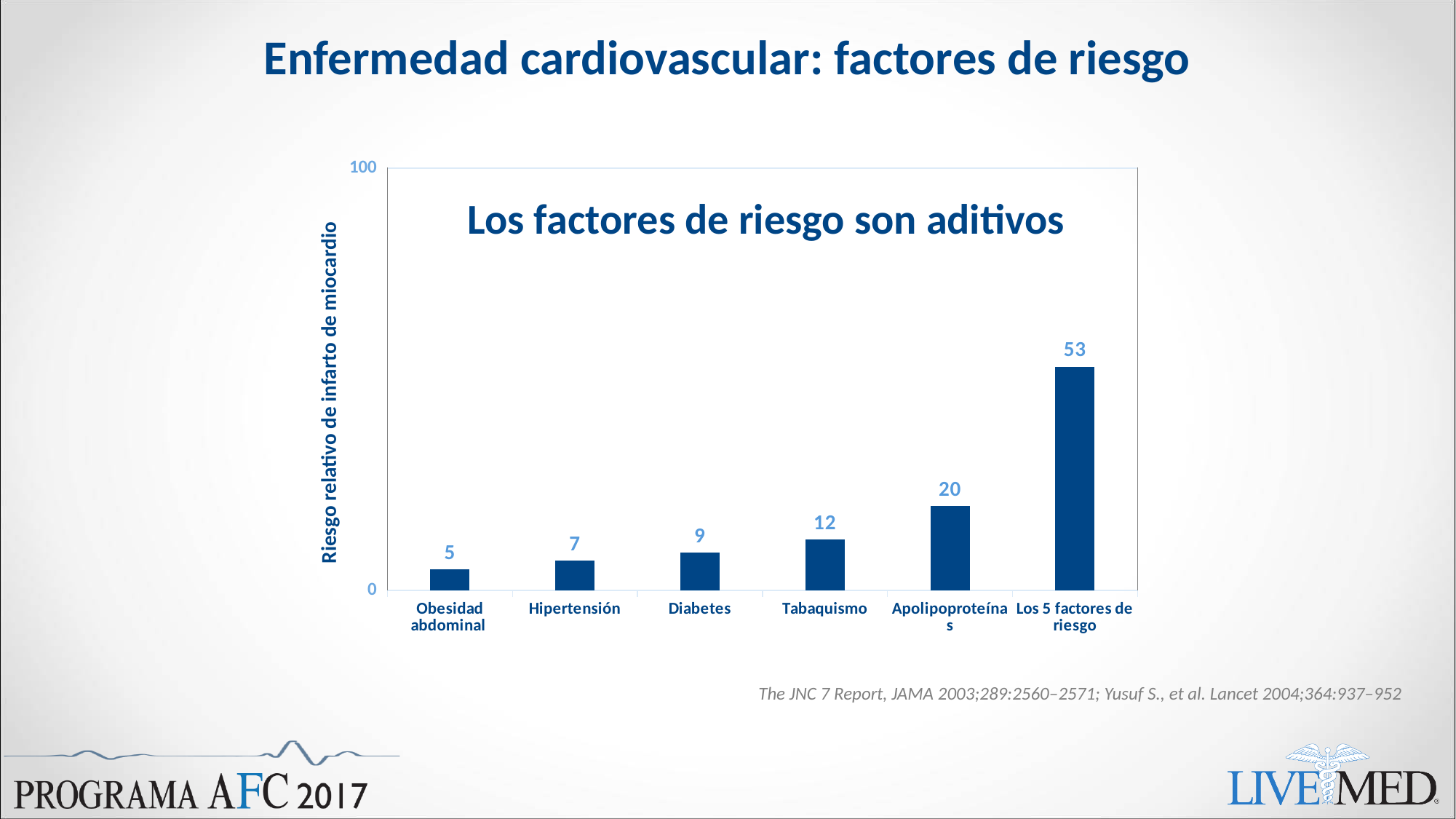
What is the value for Tabaquismo? 12 Do the values rise or fall from left to right along the x axis? Rise Which is larger, the value for Tabaquismo or the value for Diabetes? Tabaquismo How many categories are shown on the x axis? 6 What is the value for Apolipoproteínas? 20 What is the difference between the values for Diabetes and Hipertensión? 2 What kind of chart is shown on the slide? Bar chart Which category has the lowest value? Obesidad abdominal Which category has the highest value? Los 5 factores de riesgo What is the difference between the values for Los 5 factores de riesgo and Apolipoproteínas? 33 What is the value for Obesidad abdominal? 5 What is the label of the vertical axis? Riesgo relativo de infarto de miocardio